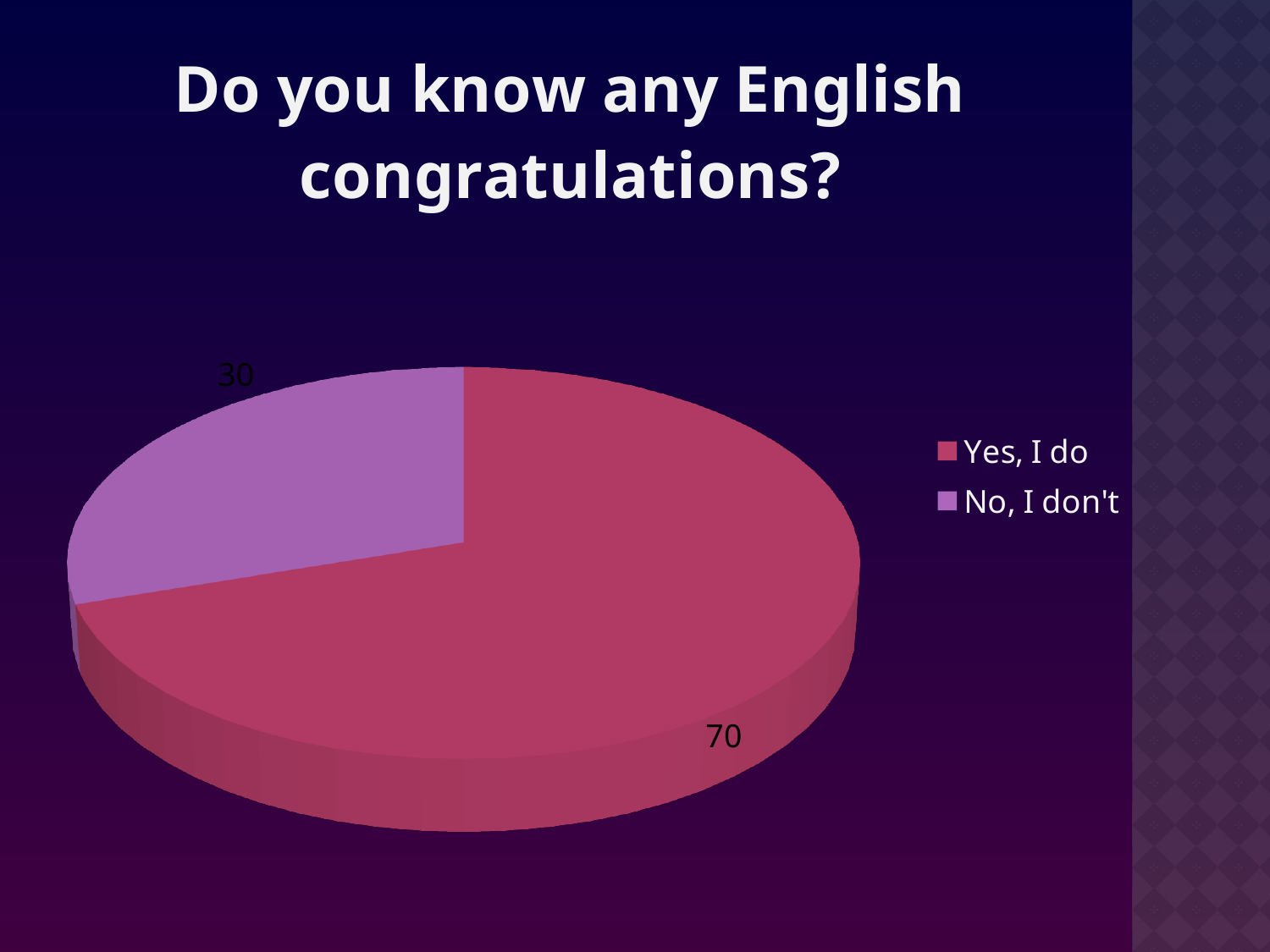
What is the value for "Yes, I do"? 70 What share of the pie does "Yes, I do" represent? 70% What kind of chart is shown on the slide? Pie chart What colour is the "No, I don't" slice? Purple How many categories does the pie chart show? 2 Which category has the largest slice? Yes, I do What share of the pie does "No, I don't" represent? 30% Which category has the smallest slice? No, I don't What is the difference between the values for "Yes, I do" and "No, I don't"? 40 What is the title of the chart? Do you know any English congratulations? What is the value for "No, I don't"? 30 Which is larger, the value for "Yes, I do" or "No, I don't"? Yes, I do